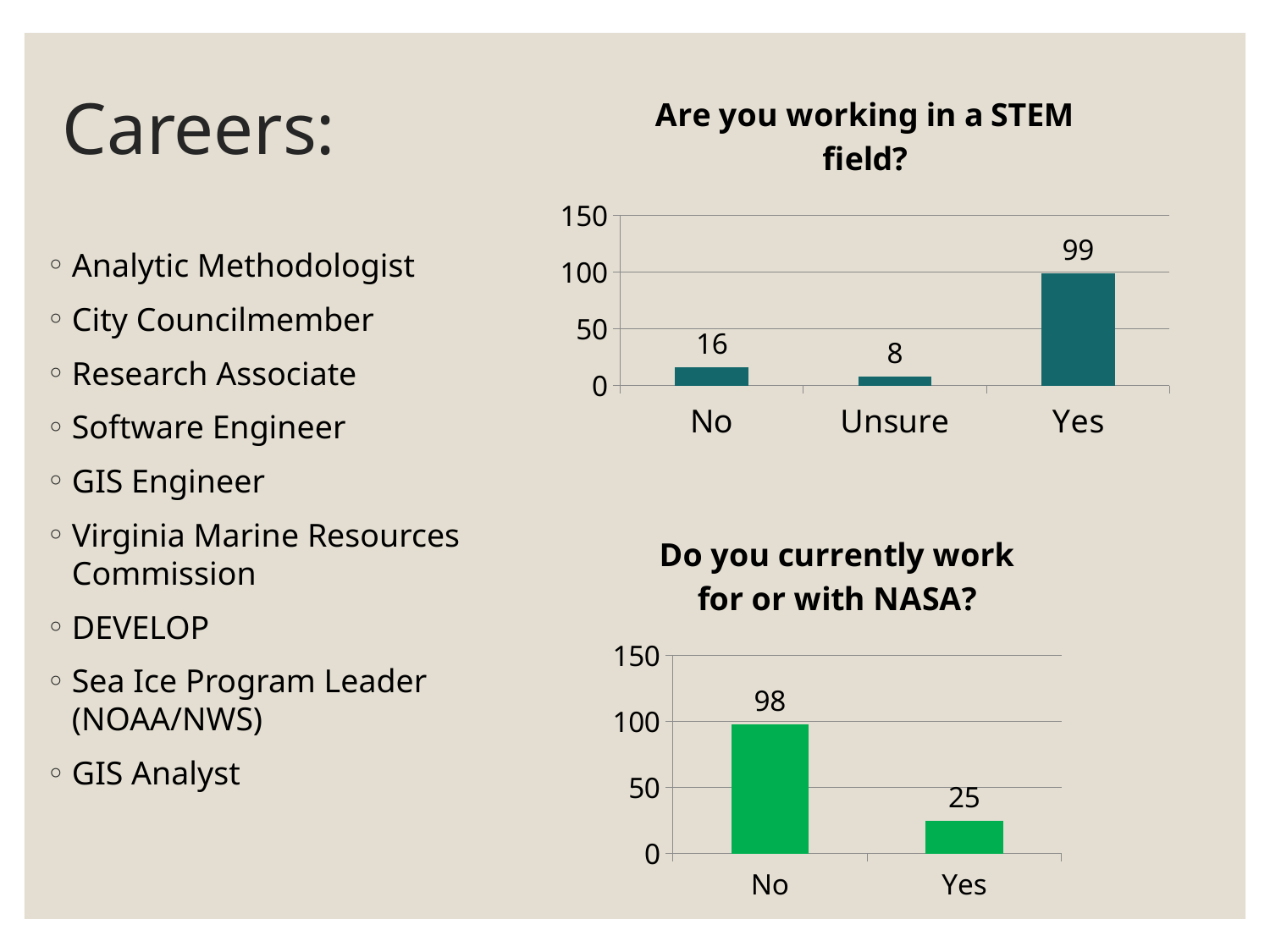
In the chart 'Are you working in a STEM field?', what is the value for Unsure? 8 In the chart 'Are you working in a STEM field?', what is the difference between the values for Yes and No? 83 What kind of chart is 'Do you currently work for or with NASA?'? Bar chart What is the title of the upper chart on the slide? Are you working in a STEM field? In the chart 'Are you working in a STEM field?', is the value for Yes greater or less than 50? greater In the chart 'Are you working in a STEM field?', which category has the lowest value? Unsure In the chart 'Do you currently work for or with NASA?', what is the value for No? 98 In the chart 'Are you working in a STEM field?', how many categories are shown on the x axis? 3 In the chart 'Do you currently work for or with NASA?', what is the value for Yes? 25 In the chart 'Do you currently work for or with NASA?', which category has the highest value? No In the chart 'Are you working in a STEM field?', what is the value for Yes? 99 In the chart 'Do you currently work for or with NASA?', what is the difference between the values for No and Yes? 73